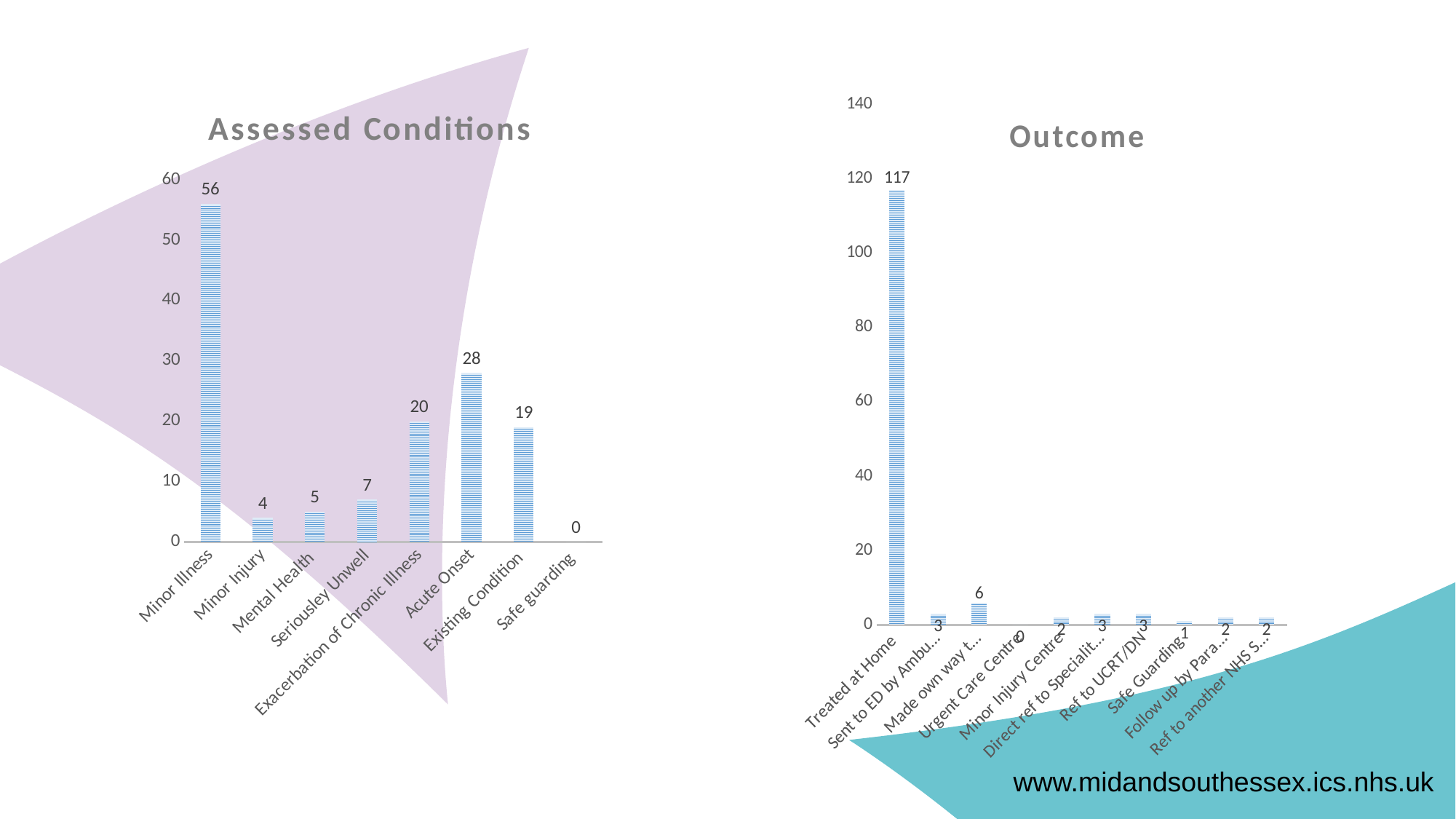
In the Outcome chart, what is the value for Treated at Home? 117 How many categories are shown in the Assessed Conditions chart? 8 In the Assessed Conditions chart, what is the value for Minor Illness? 56 In the Outcome chart, what is the value for Minor Injury Centre? 2 In the Assessed Conditions chart, what is the difference between Exacerbation of Chronic Illness and Existing Condition? 1 In the Assessed Conditions chart, which is larger, Mental Health or Seriousley Unwell? Seriousley Unwell In the Assessed Conditions chart, what is the value for Acute Onset? 28 How many categories are shown in the Outcome chart? 10 What type of chart is the Outcome chart? Bar chart In the Assessed Conditions chart, which category has the lowest value? Safe guarding In the Outcome chart, which category has the highest value? Treated at Home In the Assessed Conditions chart, which category has the highest value? Minor Illness